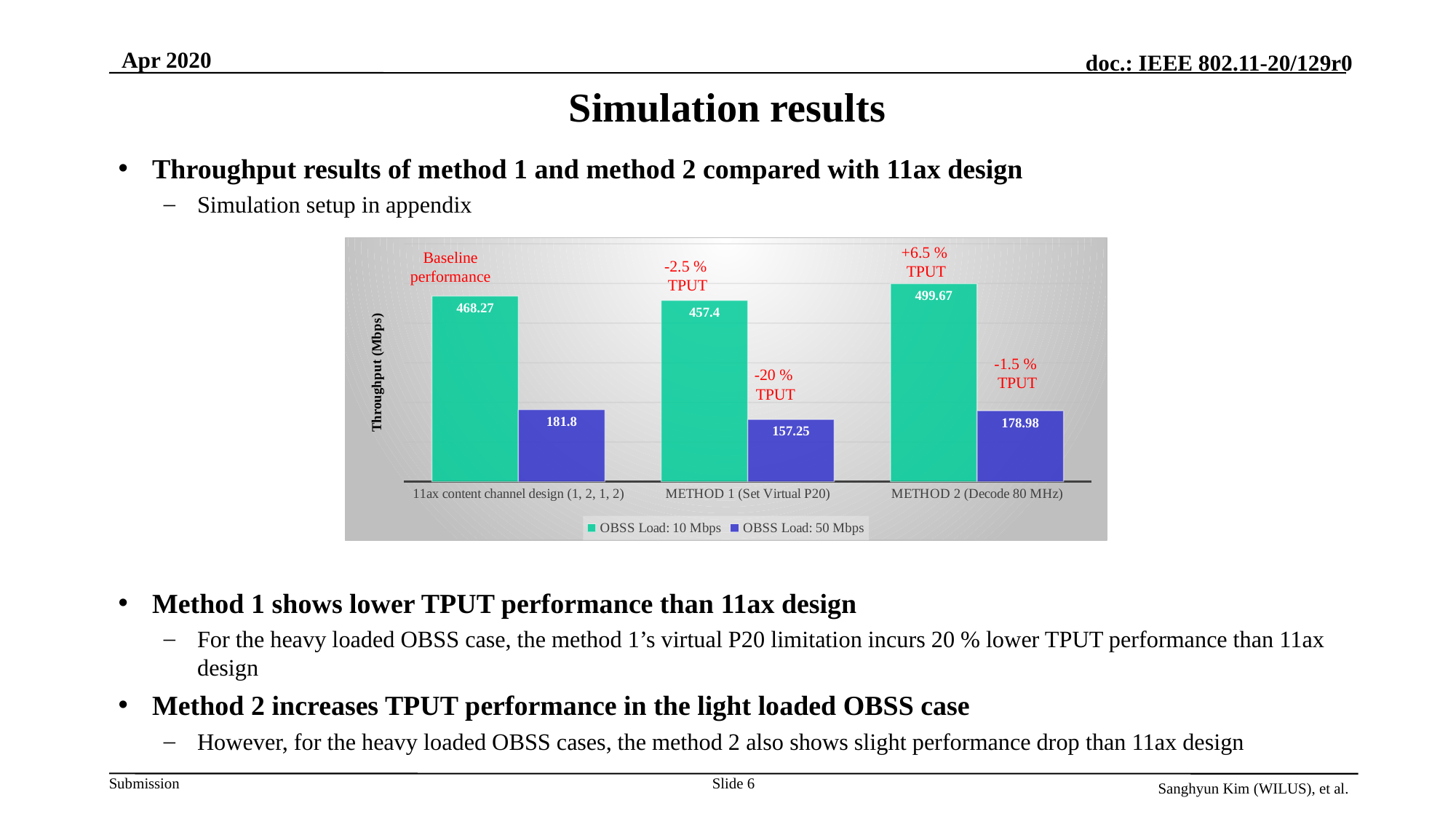
How many categories are shown on the x axis of the chart? 3 What is the throughput for METHOD 1 (Set Virtual P20) with OBSS Load: 50 Mbps? 157.25 What is the difference between the OBSS Load: 10 Mbps and OBSS Load: 50 Mbps throughput for METHOD 1 (Set Virtual P20)? 300.15 What is the difference in OBSS Load: 50 Mbps throughput between the 11ax content channel design and METHOD 2 (Decode 80 MHz)? 2.82 What is the throughput for METHOD 2 (Decode 80 MHz) with OBSS Load: 10 Mbps? 499.67 What is the label of the chart's vertical axis? Throughput (Mbps) What is the throughput for the 11ax content channel design (1, 2, 1, 2) with OBSS Load: 10 Mbps? 468.27 What kind of chart is shown on the slide? Bar chart Which is larger: the OBSS Load: 10 Mbps throughput for METHOD 1 (Set Virtual P20) or for the 11ax content channel design (1, 2, 1, 2)? 11ax content channel design (1, 2, 1, 2) Which category has the lowest throughput for OBSS Load: 50 Mbps? METHOD 1 (Set Virtual P20) Which category has the highest throughput for OBSS Load: 10 Mbps? METHOD 2 (Decode 80 MHz) How many series does the chart legend list? 2